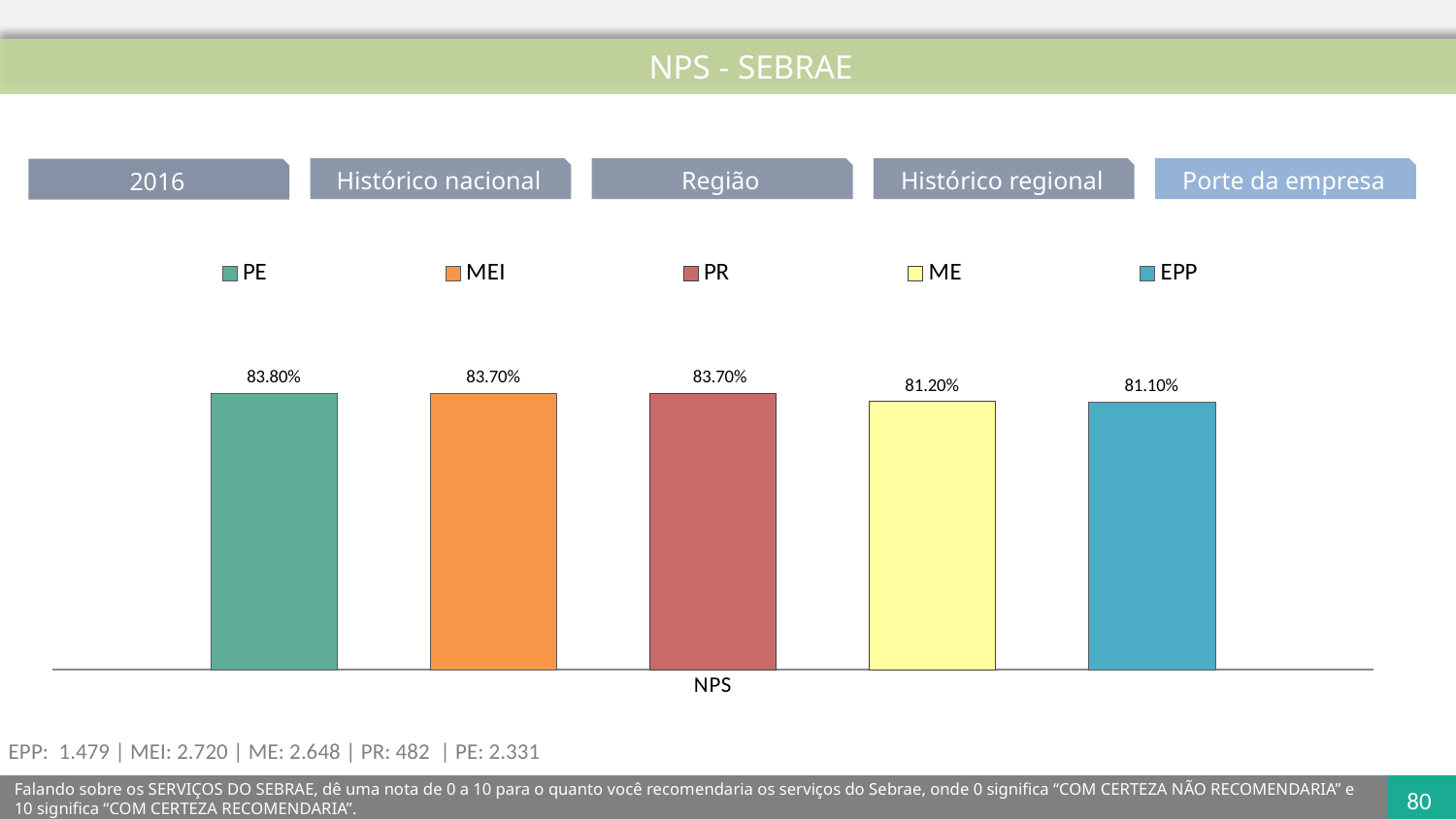
What is the value for ME in the NPS chart? 81.20% Which series has the highest value in the NPS chart? PE What is the value for EPP in the NPS chart? 81.10% What is the difference between the PE value and the ME value? 2.60 percentage points How many series does the legend list? 5 What is the value for MEI in the NPS chart? 83.70% What kind of chart is shown on the slide? Bar chart What is the difference between the MEI value and the EPP value? 2.60 percentage points Which series has the lowest value in the NPS chart? EPP What is the title of the slide containing the chart? NPS - SEBRAE Which is larger, the value for PR or the value for ME? PR What is the value for PE in the NPS chart? 83.80%